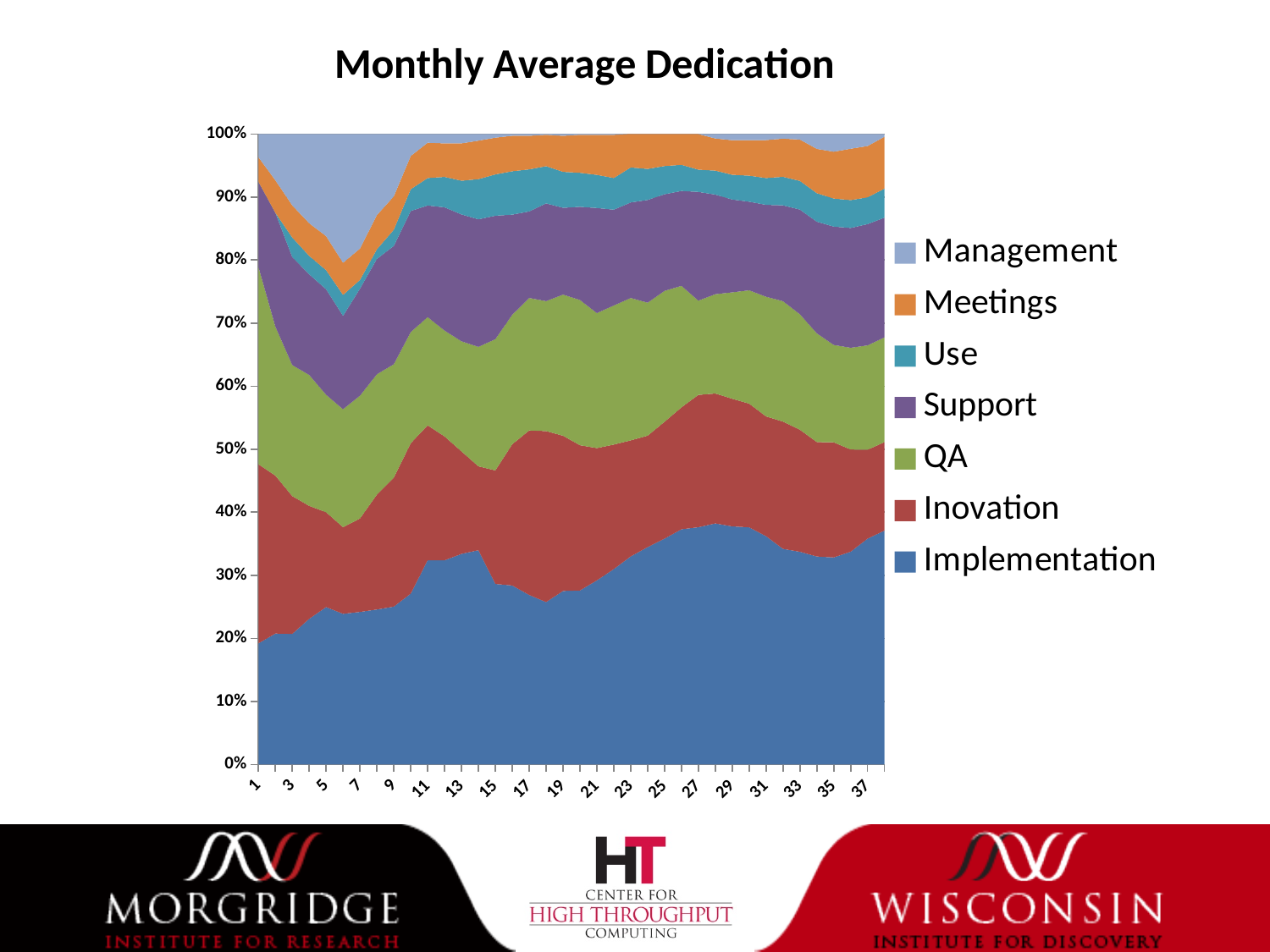
Which series is listed at the bottom of the legend? Implementation How many series does the legend list? 7 At month 37, which series has the larger share: Implementation or Use? Implementation Does the Management share generally rise or fall from month 5 to month 37? fall Does the Implementation share generally rise or fall from month 1 to month 37? rise What kind of chart is shown on the slide? Stacked area chart At month 5, which series has the larger share: Management or Use? Management Is the Implementation share at month 27 greater or less than 30%? greater Is the Implementation share at month 5 greater or less than 30%? less What is the title of the chart? Monthly Average Dedication What is the highest value shown on the vertical axis? 100% Is the Implementation share at month 37 greater or less than 30%? greater